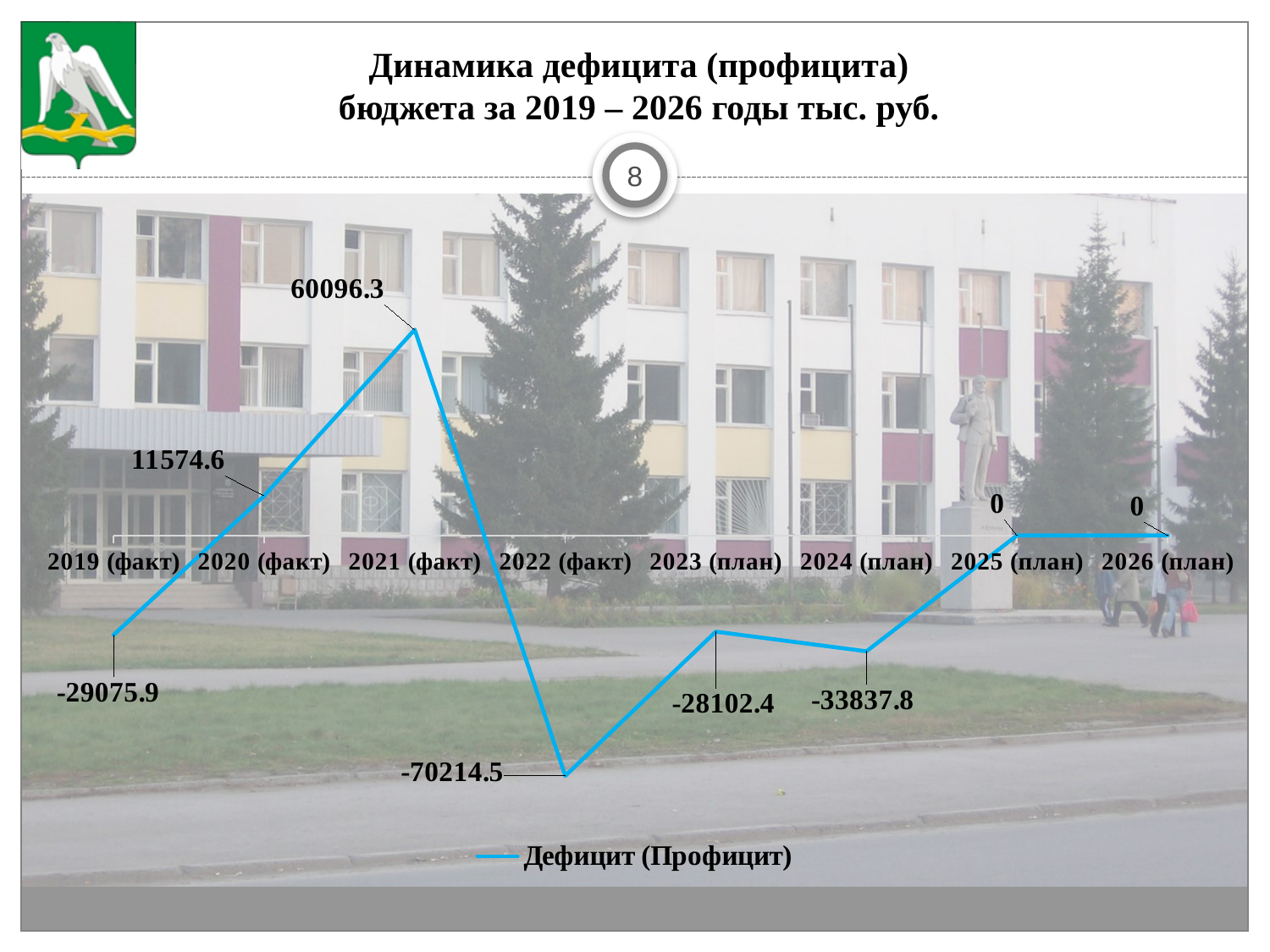
What is the value for 2024 (план)? -33837.8 How many data points are plotted on the chart? 8 How many series does the legend list? 1 What is the value for 2021 (факт)? 60096.3 Which year has the lowest value on the chart? 2022 (факт) What is the difference between the values for 2021 (факт) and 2020 (факт)? 48521.7 What is the legend entry for the plotted series? Дефицит (Профицит) Which is larger, the value for 2023 (план) or the value for 2024 (план)? 2023 (план) Which year has the highest value on the chart? 2021 (факт) What kind of chart is shown on the slide? Line chart What is the value for 2022 (факт)? -70214.5 What is the value for 2019 (факт)? -29075.9